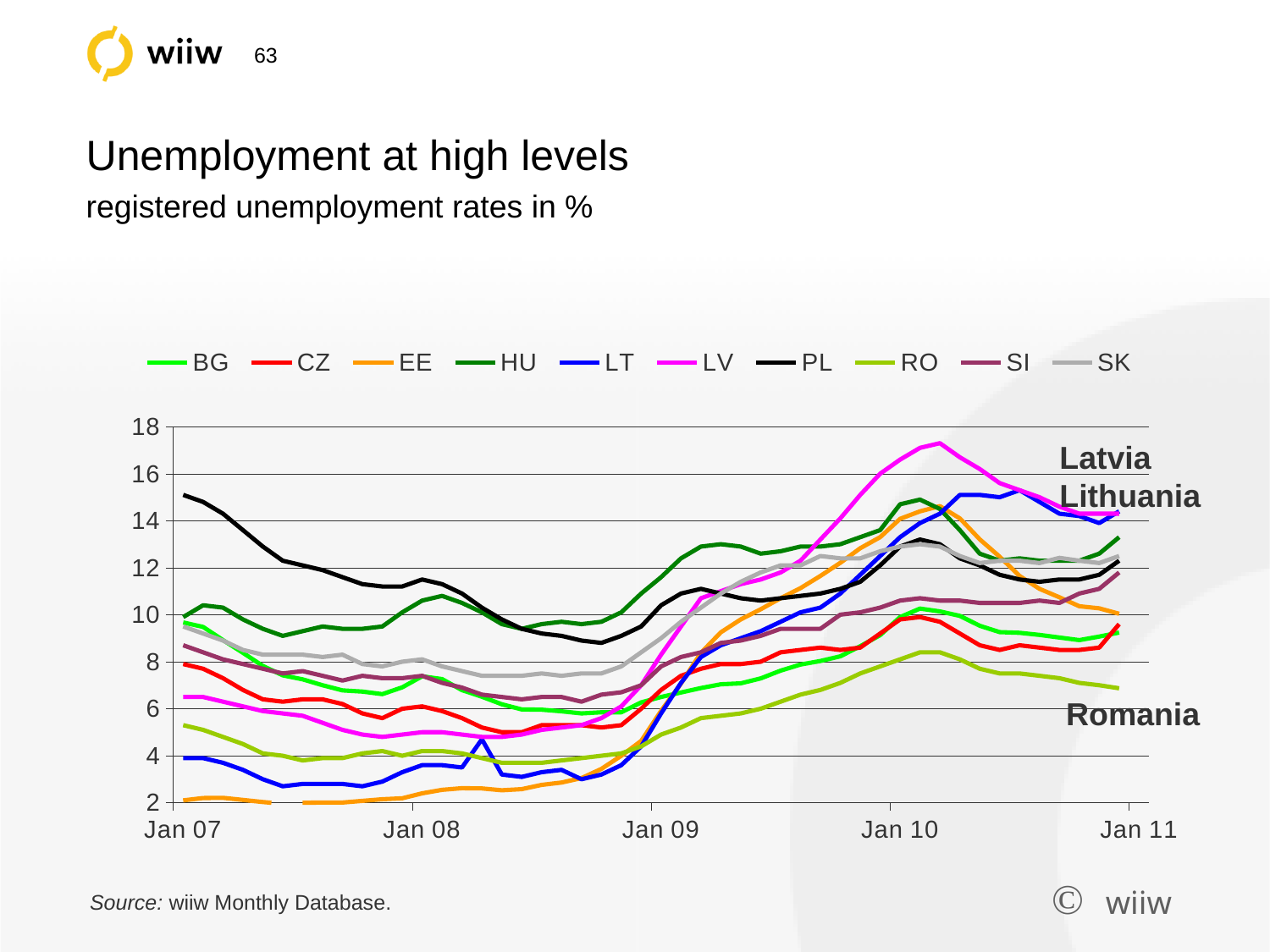
Does the PL series rise or fall between Jan 07 and Jan 08? fall Is the value for PL at Jan 07 greater or less than 14? greater How many series does the legend list? 10 Is the value for LT at Jan 07 greater or less than 6? less Which is larger at Jan 10, the value for LV or the value for RO? LV What kind of chart is shown on the slide? line chart Is the peak value for LV greater or less than 16? greater Which series has the highest value at Jan 07? PL What is the subtitle of the chart on the slide? registered unemployment rates in % Which series has the lowest value at Jan 07? EE Which series has the lowest value at Jan 11? RO Does the LV series rise or fall between Jan 07 and Jan 10? rise